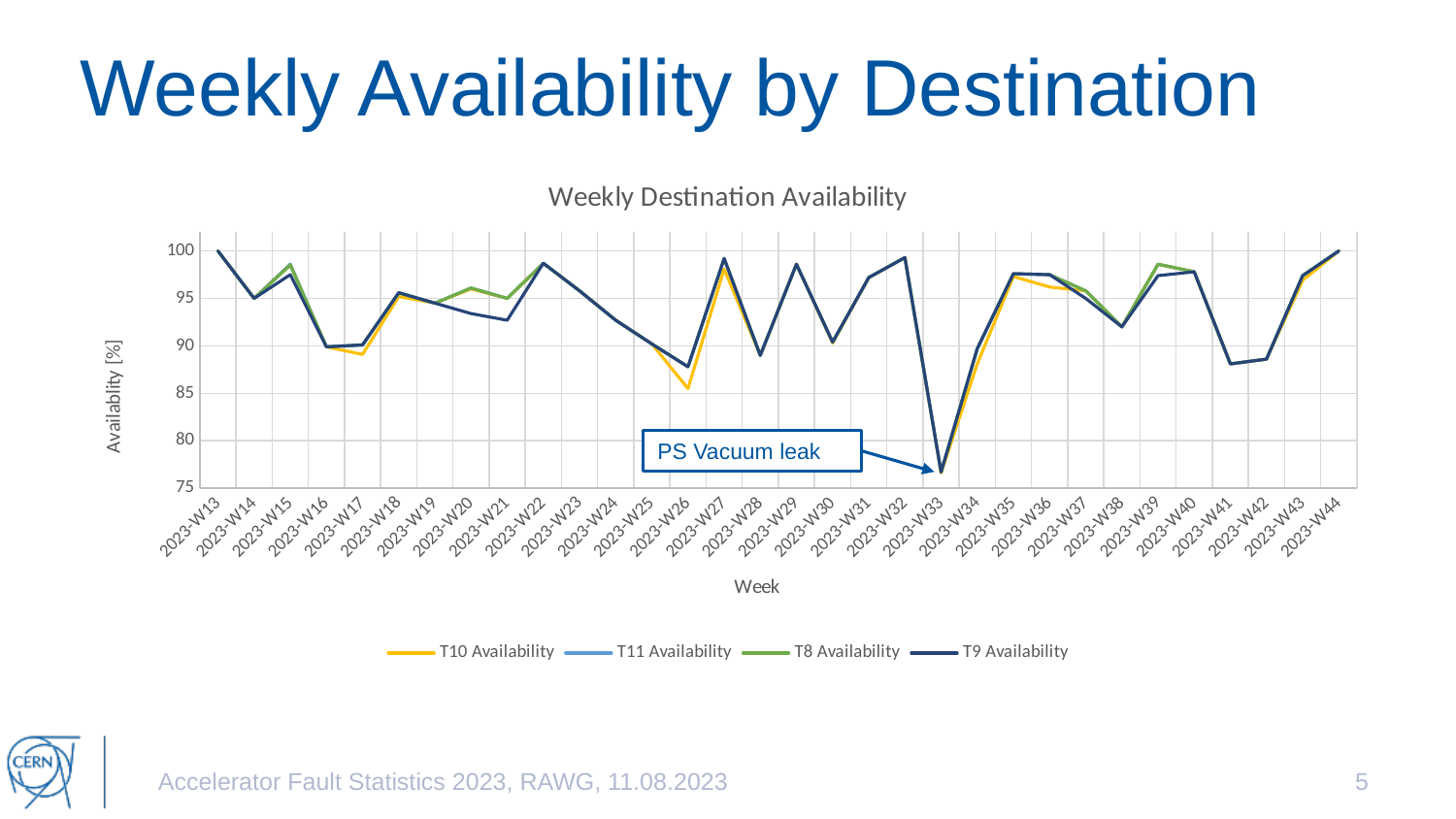
What is the title of the chart? Weekly Destination Availability How many series does the legend list? 4 Is the T10 Availability value for 2023-W26 greater or less than 90? less How many weeks are plotted along the x axis? 32 In which week is the T9 Availability lowest? 2023-W33 What kind of chart is shown on the slide? line chart Is the T9 Availability value for 2023-W32 greater or less than 95? greater Does the T9 Availability rise or fall from 2023-W13 to 2023-W16? fall Which week has the higher T9 Availability, 2023-W27 or 2023-W28? 2023-W27 Is the T9 Availability value for 2023-W41 greater or less than 90? less What event does the annotation on the chart point to at 2023-W33? PS Vacuum leak